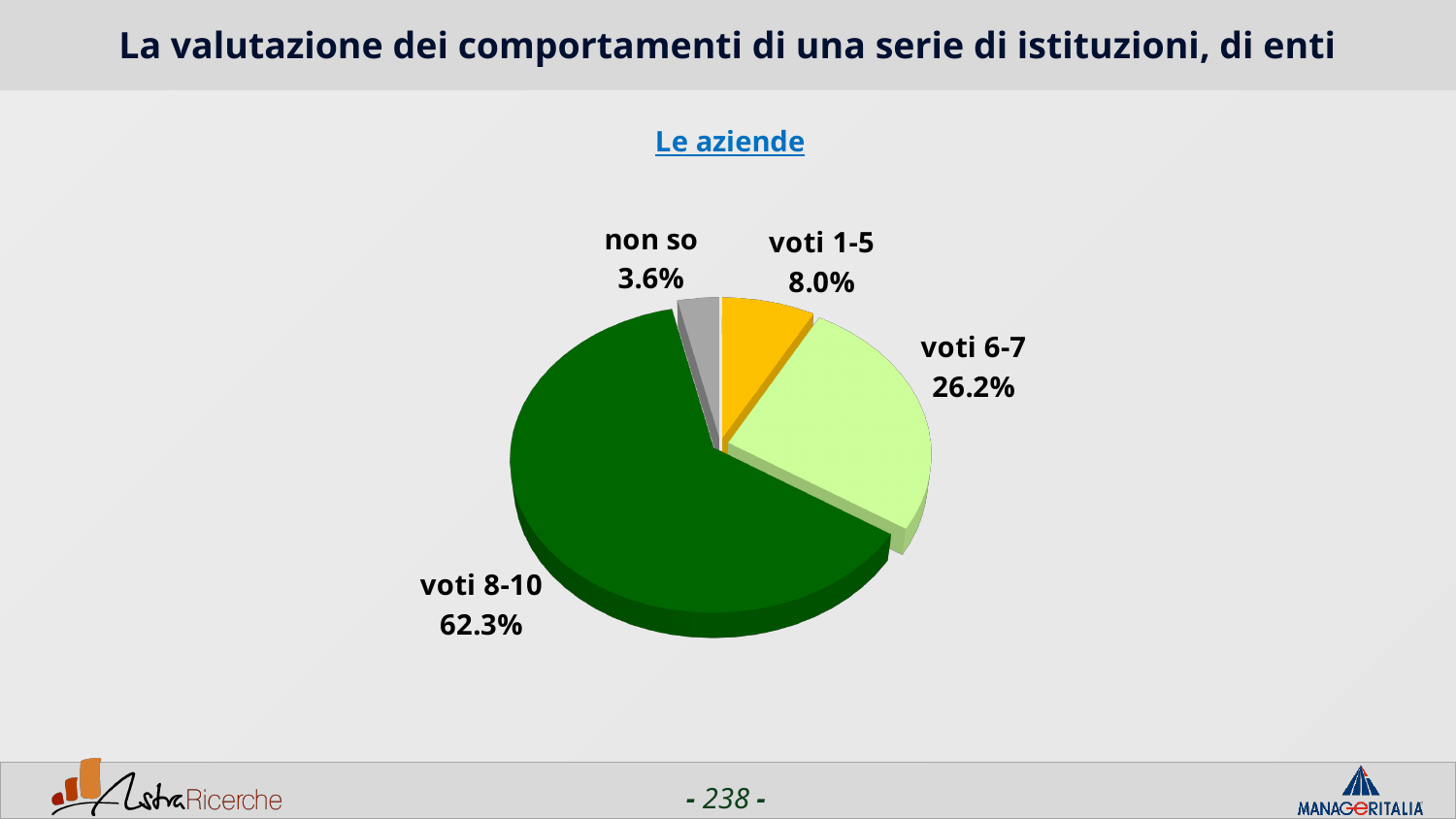
What is the value for "voti 6-7"? 26.2% How many slices does the pie chart have? 4 What colour is the "voti 1-5" slice? orange What is the value for "non so"? 3.6% What is the title of the chart? Le aziende Which category has the largest share of the pie? voti 8-10 What is the value for "voti 8-10"? 62.3% What is the value for "voti 1-5"? 8.0% What is the difference between the values for "voti 8-10" and "voti 6-7"? 36.1% Which category has the smallest share of the pie? non so What kind of chart is shown on the slide? pie chart Which is larger, the value for "voti 1-5" or the value for "non so"? voti 1-5